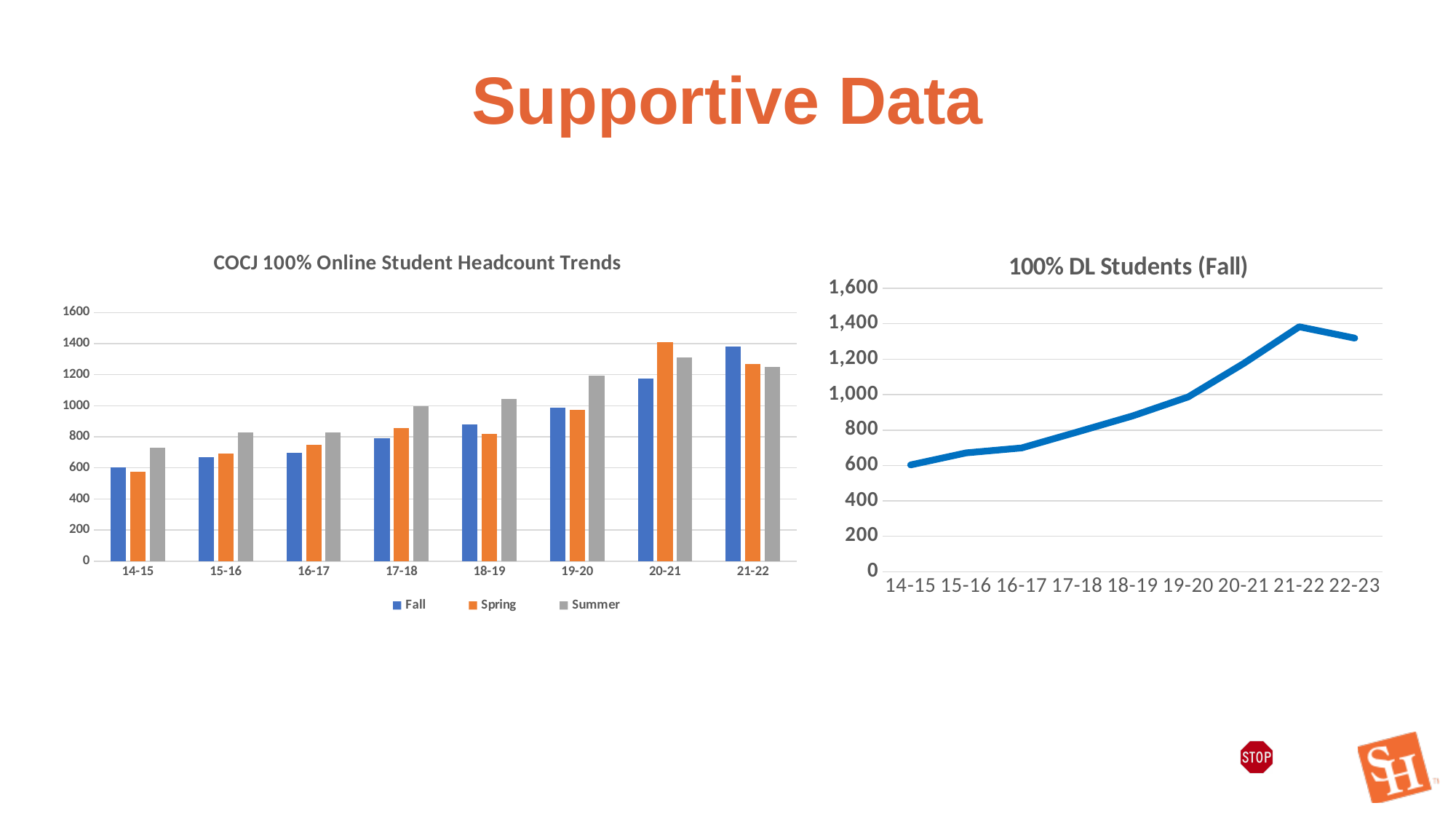
What type of chart is the 'COCJ 100% Online Student Headcount Trends' chart? bar chart In the 'COCJ 100% Online Student Headcount Trends' chart, is the Fall value for 16-17 greater or less than 800? less How many series does the legend of the 'COCJ 100% Online Student Headcount Trends' chart list? 3 In the 'COCJ 100% Online Student Headcount Trends' chart, which is larger for 18-19: the Fall value or the Summer value? Summer How many academic years are shown on the x axis of the '100% DL Students (Fall)' chart? 9 How many academic years are shown on the x axis of the 'COCJ 100% Online Student Headcount Trends' chart? 8 In the 'COCJ 100% Online Student Headcount Trends' chart, which academic year has the highest Spring value? 20-21 In the 'COCJ 100% Online Student Headcount Trends' chart, is the Summer value for 19-20 greater or less than 1000? greater In the '100% DL Students (Fall)' chart, which academic year has the highest value? 21-22 In the 'COCJ 100% Online Student Headcount Trends' chart, which academic year has the lowest Fall value? 14-15 In the '100% DL Students (Fall)' chart, is the value for 22-23 greater or less than 1,200? greater What type of chart is the '100% DL Students (Fall)' chart? line chart